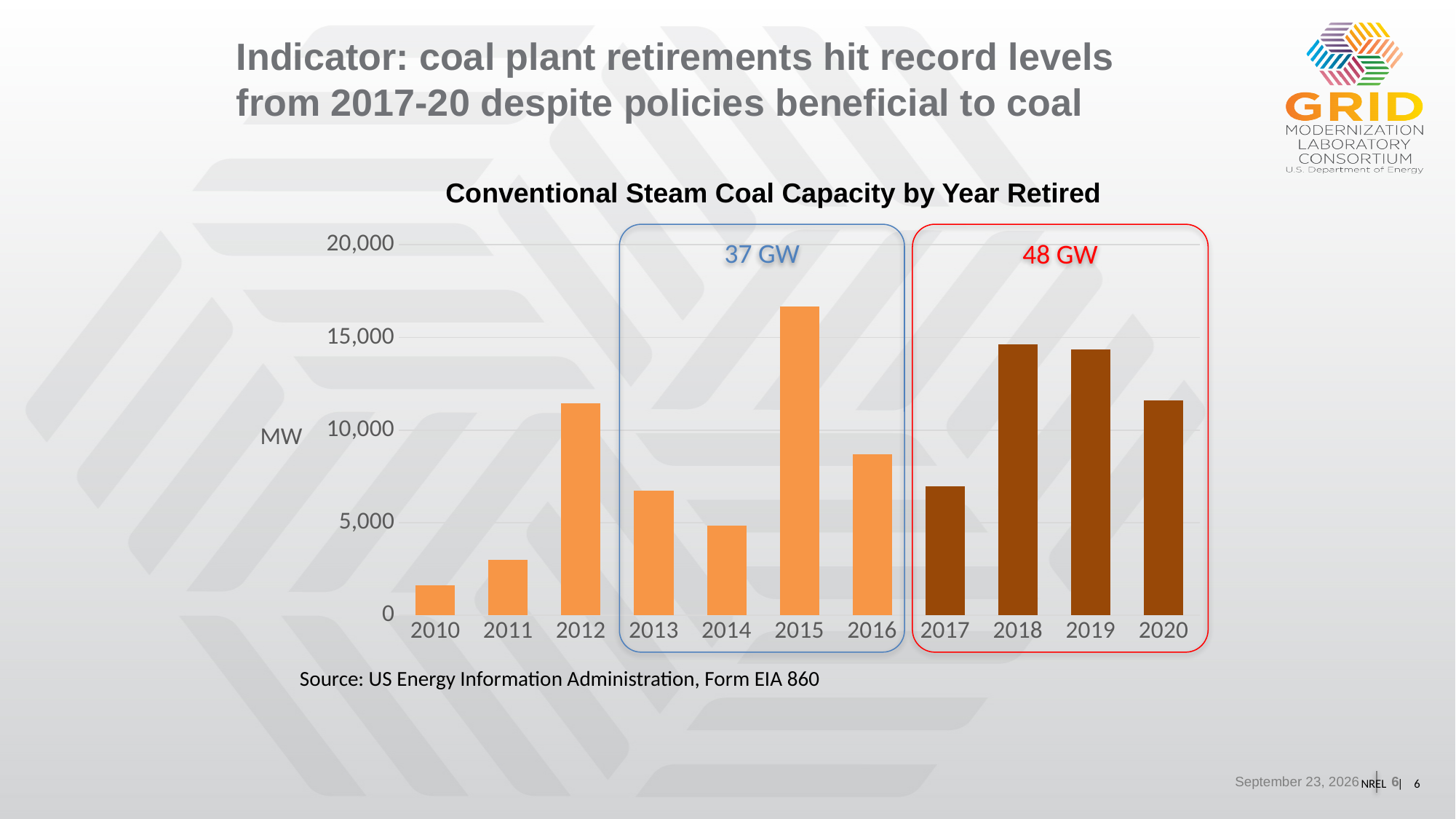
How many years are shown on the x axis of the chart? 11 What total is annotated for the 2017-2020 period in the red box? 48 GW Do the values rise or fall from 2010 to 2012? rise What kind of chart is shown on the slide? bar chart Which year has the lowest retired coal capacity? 2010 Is the value for 2011 greater or less than 5,000? less Is the value for 2018 greater or less than 10,000? greater Which year has the highest retired coal capacity? 2015 Is the value for 2015 greater or less than 15,000? greater What is the title of the chart? Conventional Steam Coal Capacity by Year Retired Which year has the larger retired capacity, 2012 or 2013? 2012